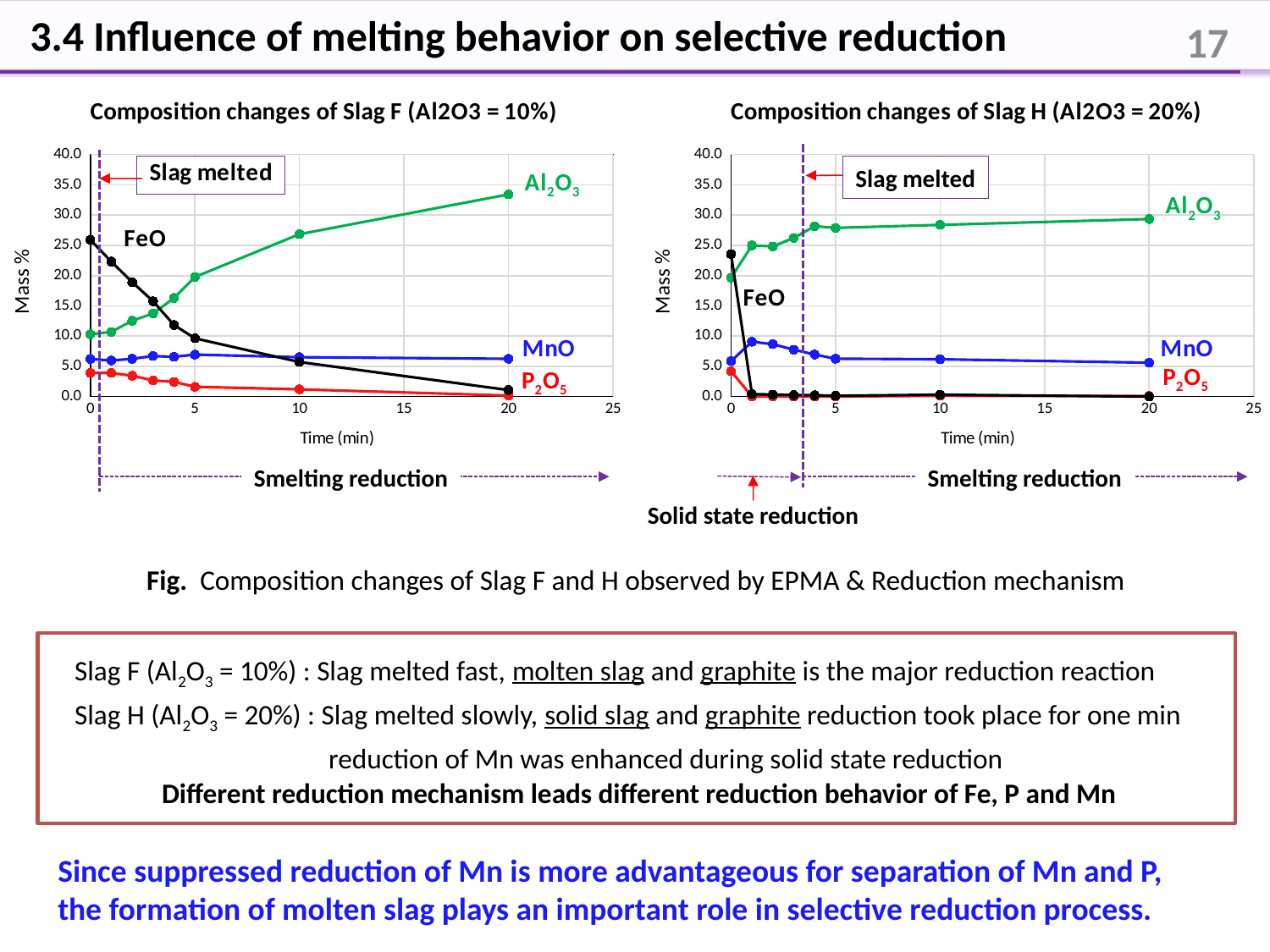
What is the x-axis label of the 'Composition changes of Slag H (Al2O3 = 20%)' chart? Time (min) In the 'Composition changes of Slag F (Al2O3 = 10%)' chart, is the FeO value at 0 min greater or less than 20.0? greater In the 'Composition changes of Slag H (Al2O3 = 20%)' chart, is the FeO value at 5 min greater or less than 5.0? less In the 'Composition changes of Slag F (Al2O3 = 10%)' chart, which is larger at 20 min, MnO or P2O5? MnO In the 'Composition changes of Slag F (Al2O3 = 10%)' chart, does the Al2O3 series rise or fall over time? rise In the 'Composition changes of Slag F (Al2O3 = 10%)' chart, which series has the highest value at 20 min? Al2O3 In the 'Composition changes of Slag H (Al2O3 = 20%)' chart, which is larger at 0 min, FeO or Al2O3? FeO What kind of chart is the 'Composition changes of Slag F (Al2O3 = 10%)' chart? line chart How many series are plotted in the 'Composition changes of Slag H (Al2O3 = 20%)' chart? 4 In the 'Composition changes of Slag H (Al2O3 = 20%)' chart, is the Al2O3 value at 20 min greater or less than 25.0? greater In the 'Composition changes of Slag F (Al2O3 = 10%)' chart, does the FeO series rise or fall over time? fall